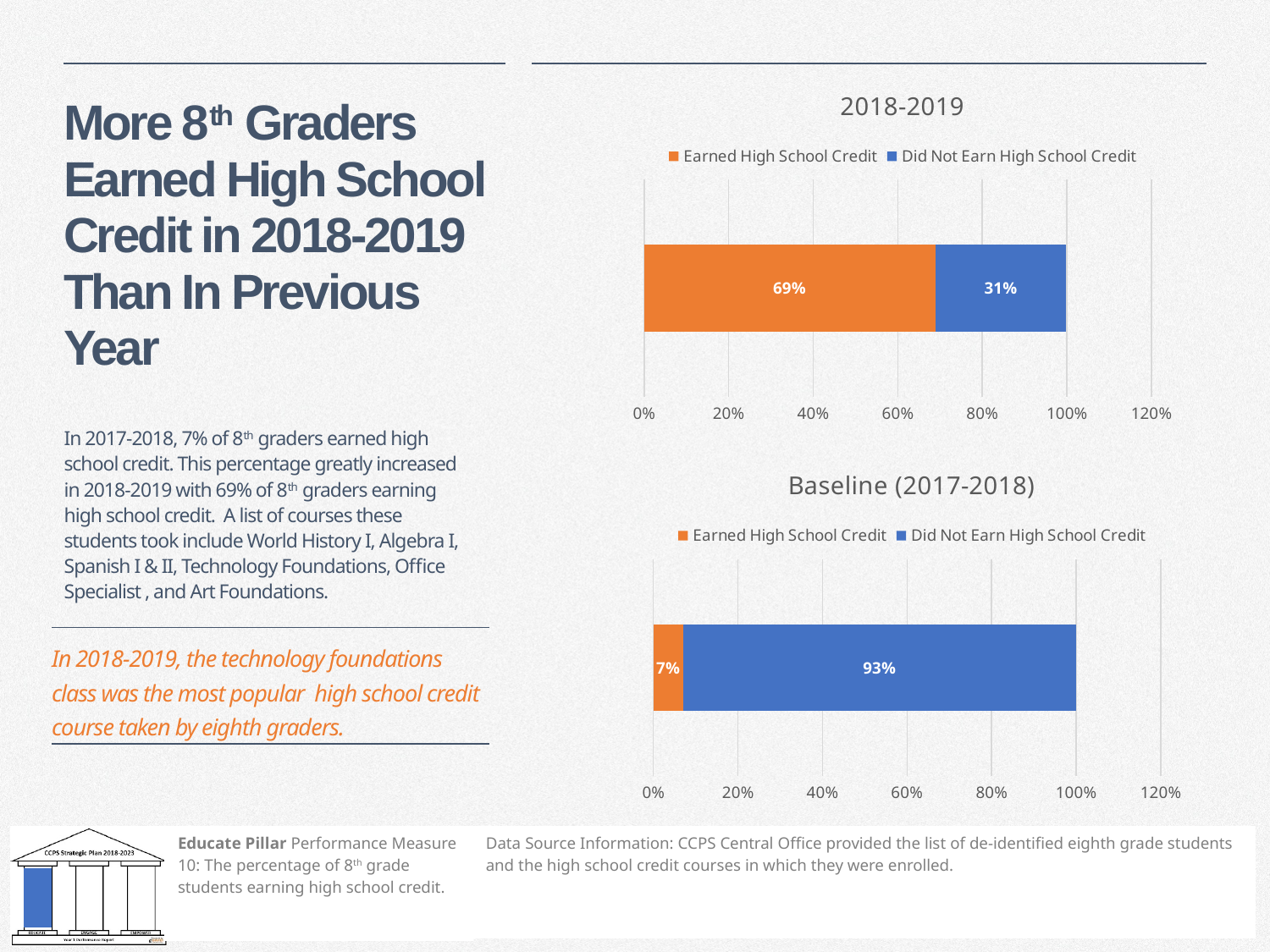
In the Baseline (2017-2018) chart, what is the value for Did Not Earn High School Credit? 93% In the 2018-2019 chart, what colour represents Earned High School Credit? Orange What type of chart is the 2018-2019 chart? Bar chart In the Baseline (2017-2018) chart, what is the value for Earned High School Credit? 7% In the 2018-2019 chart, what is the total of the stacked bar? 100% How many series does the legend of the Baseline (2017-2018) chart list? 2 In the 2018-2019 chart, what percentage of 8th graders earned high school credit? 69% In the Baseline (2017-2018) chart, what is the difference between the Did Not Earn High School Credit and Earned High School Credit values? 86% In the 2018-2019 chart, what is the difference between the Earned High School Credit and Did Not Earn High School Credit values? 38% In the 2018-2019 chart, which series has the larger value, Earned High School Credit or Did Not Earn High School Credit? Earned High School Credit In the 2018-2019 chart, what is the value for Did Not Earn High School Credit? 31% In the Baseline (2017-2018) chart, which series has the smaller value? Earned High School Credit